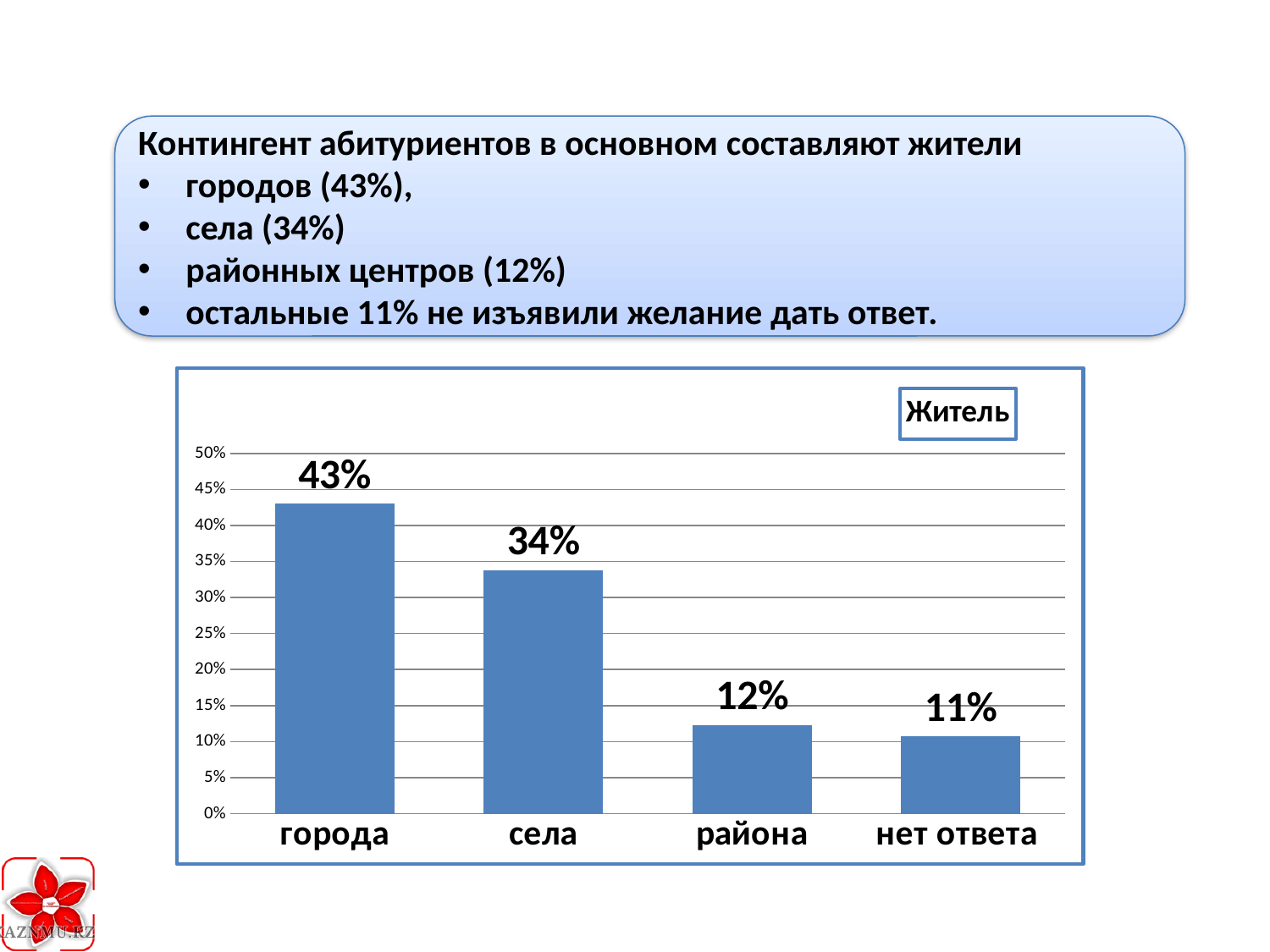
Which category has the highest value? города What is the value for района? 12% What is the value for города? 43% How many categories are shown on the x axis? 4 What is the value for села? 34% What kind of chart is shown? bar chart What is the value for нет ответа? 11% What is the difference between the values for города and села? 9% Do the values rise or fall from left to right along the x axis? fall Which category has the lowest value? нет ответа Which is larger, the value for села or the value for района? села What is the legend entry shown on the chart? Житель